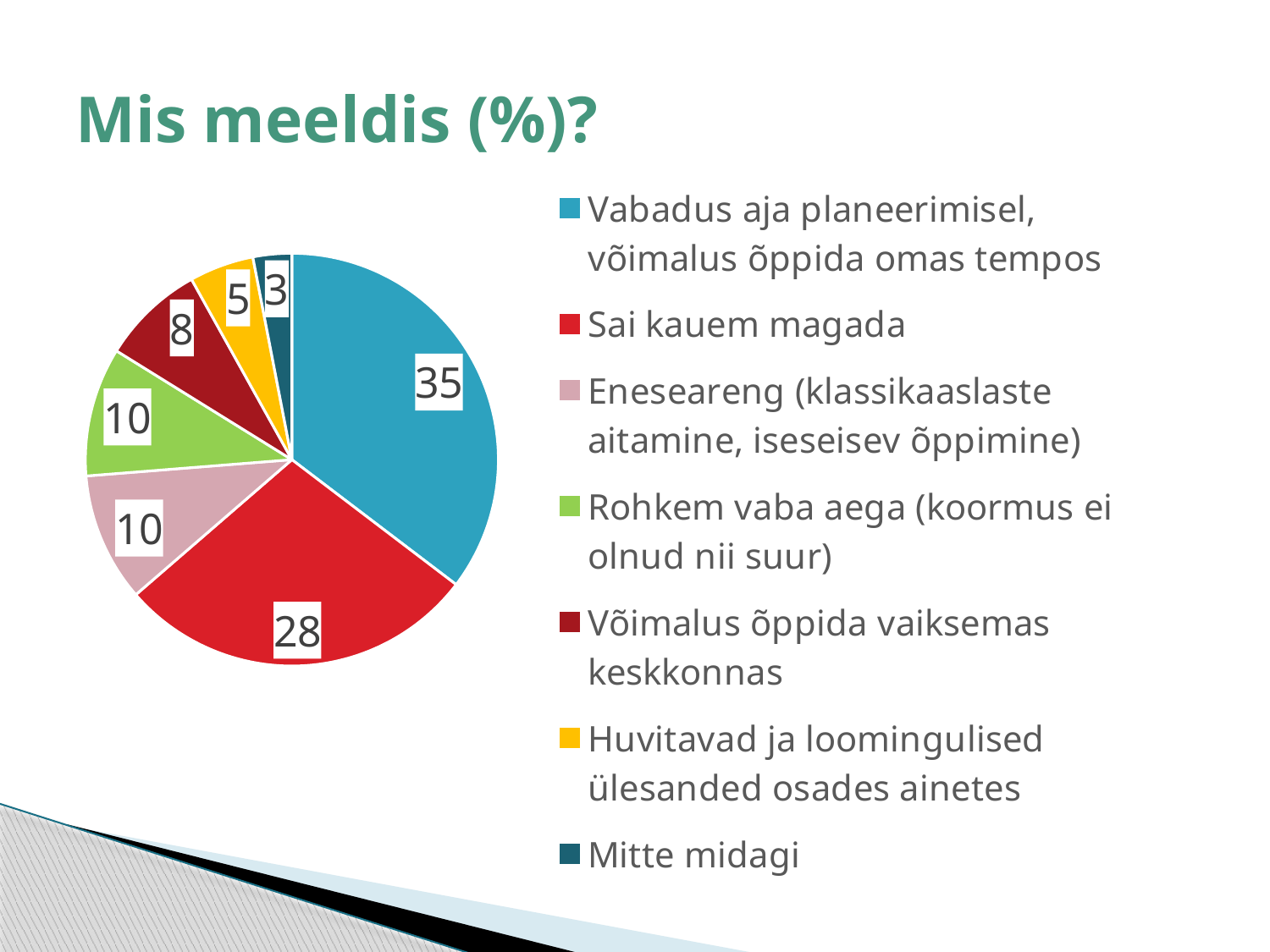
What is the value for "Võimalus õppida vaiksemas keskkonnas"? 8 What type of chart is shown on the slide? pie chart What is the value for "Sai kauem magada"? 28 How many slices does the pie chart have? 7 Which is larger, the value for "Võimalus õppida vaiksemas keskkonnas" or the value for "Huvitavad ja loomingulised ülesanded osades ainetes"? Võimalus õppida vaiksemas keskkonnas Which category has the smallest slice of the pie? Mitte midagi Which category has the largest slice of the pie? Vabadus aja planeerimisel, võimalus õppida omas tempos What colour is the slice for "Rohkem vaba aega (koormus ei olnud nii suur)"? green What is the value for "Mitte midagi"? 3 What is the difference between the values for "Vabadus aja planeerimisel, võimalus õppida omas tempos" and "Sai kauem magada"? 7 What is the value for "Huvitavad ja loomingulised ülesanded osades ainetes"? 5 What is the title of the slide? Mis meeldis (%)?